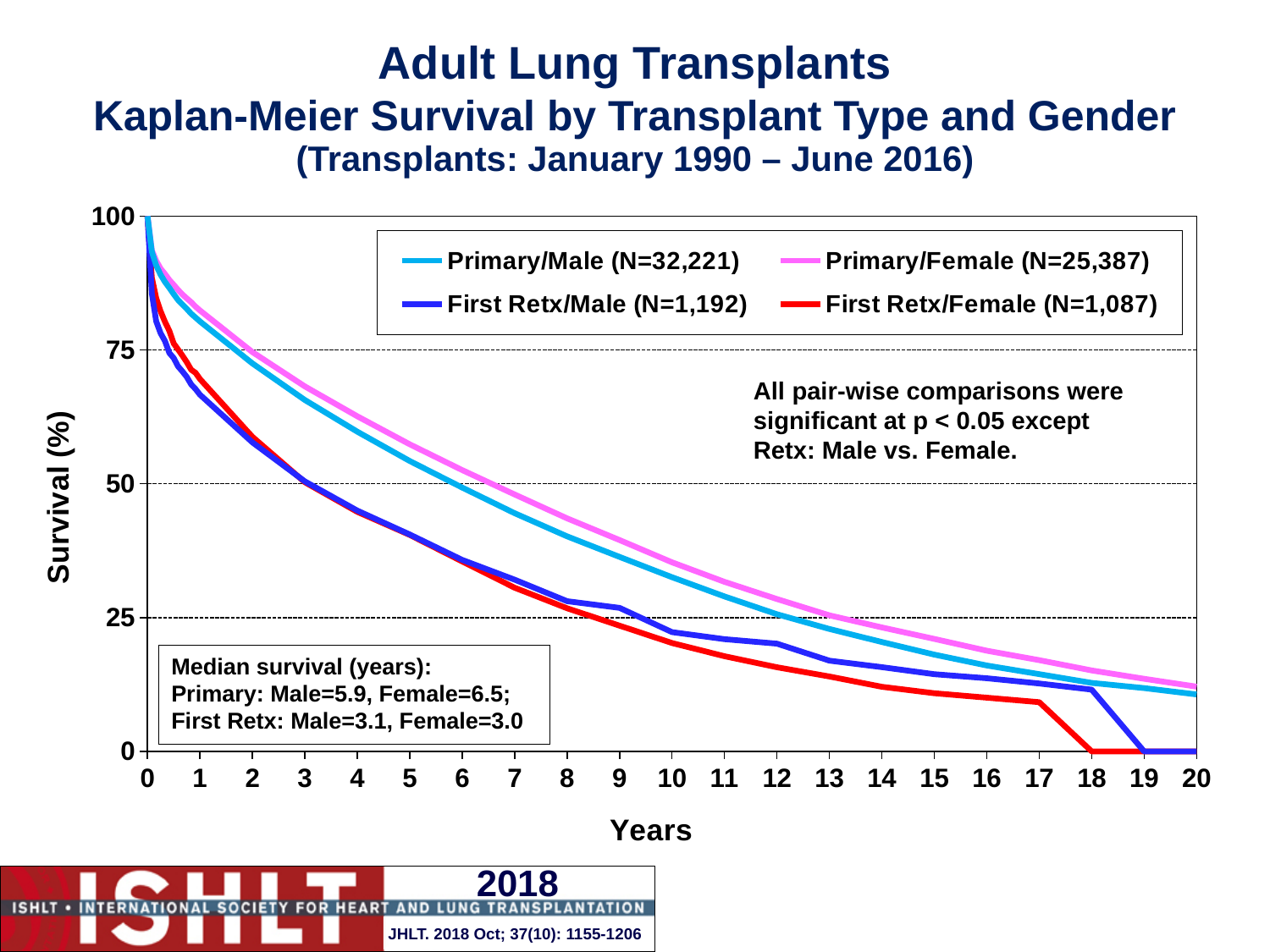
Do the survival curves rise or fall as years increase? fall What kind of chart is shown on the slide? line chart Which group has the highest survival at 10 years? Primary/Female What colour is the First Retx/Female survival curve? red At 15 years, which has higher survival: Primary/Female or First Retx/Female? Primary/Female How many series does the legend list? 4 What is the N for the Primary/Male group shown in the legend? 32,221 Is the survival for First Retx/Female at 10 years greater or less than 25? less Is the survival for Primary/Male at 1 year greater or less than 75? greater Which group has the lowest survival at 10 years? First Retx/Female Is the survival for Primary/Female at 5 years greater or less than 50? greater What is the median survival in years for Primary/Female transplants, as stated on the slide? 6.5